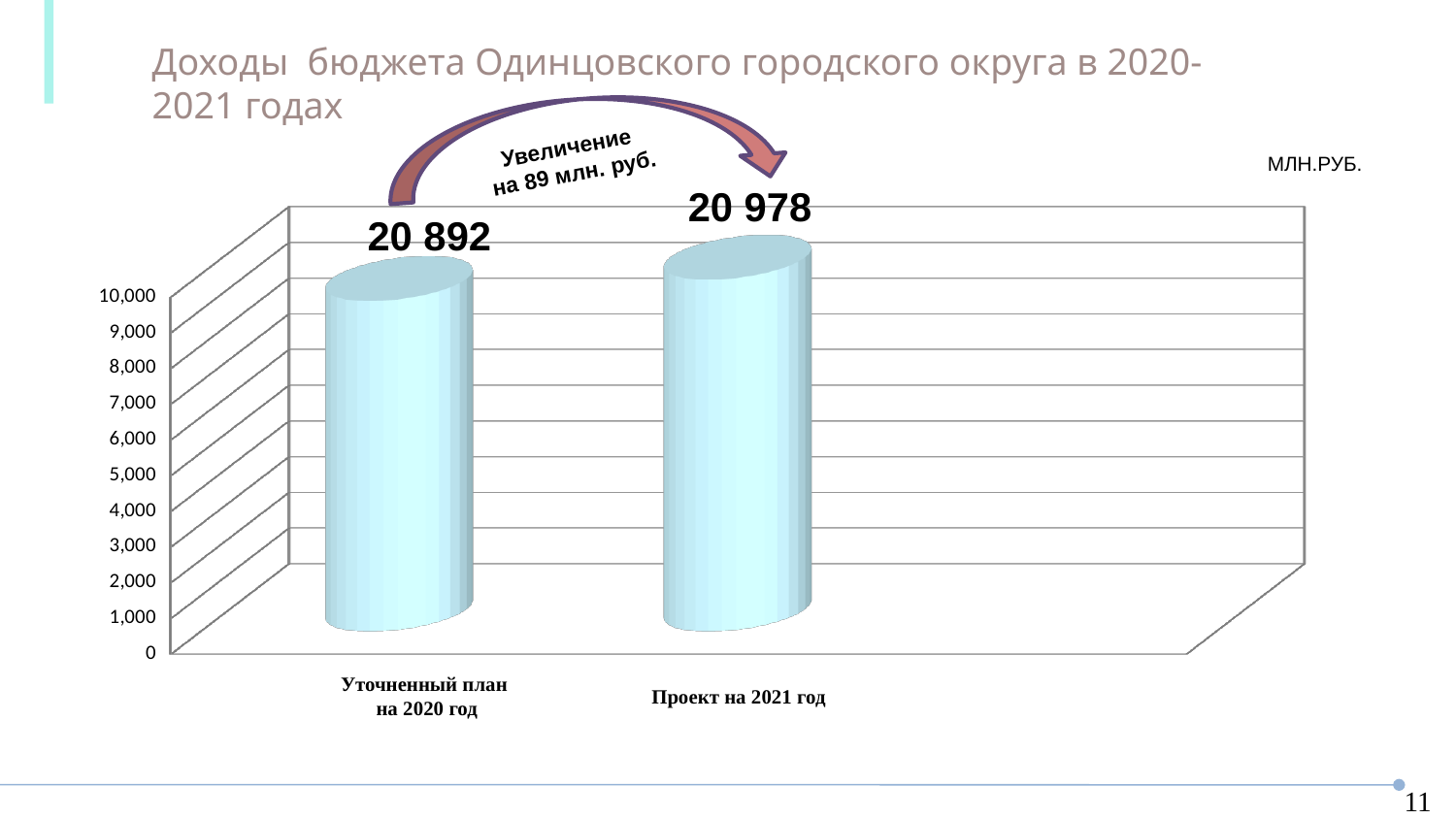
Which category has the highest value? Проект на 2021 год Which is larger: the value for "Уточненный план на 2020 год" or for "Проект на 2021 год"? Проект на 2021 год What is the value for "Уточненный план на 2020 год"? 20 892 Which category has the lowest value? Уточненный план на 2020 год What is the value for "Проект на 2021 год"? 20 978 According to the arrow annotation on the chart, by how much does the value increase? на 89 млн. руб. What unit of measurement is indicated on the slide for the chart values? МЛН.РУБ. Do the values rise or fall from the 2020 plan to the 2021 project? rise What kind of chart is shown on the slide? bar chart How many categories are shown on the chart? 2